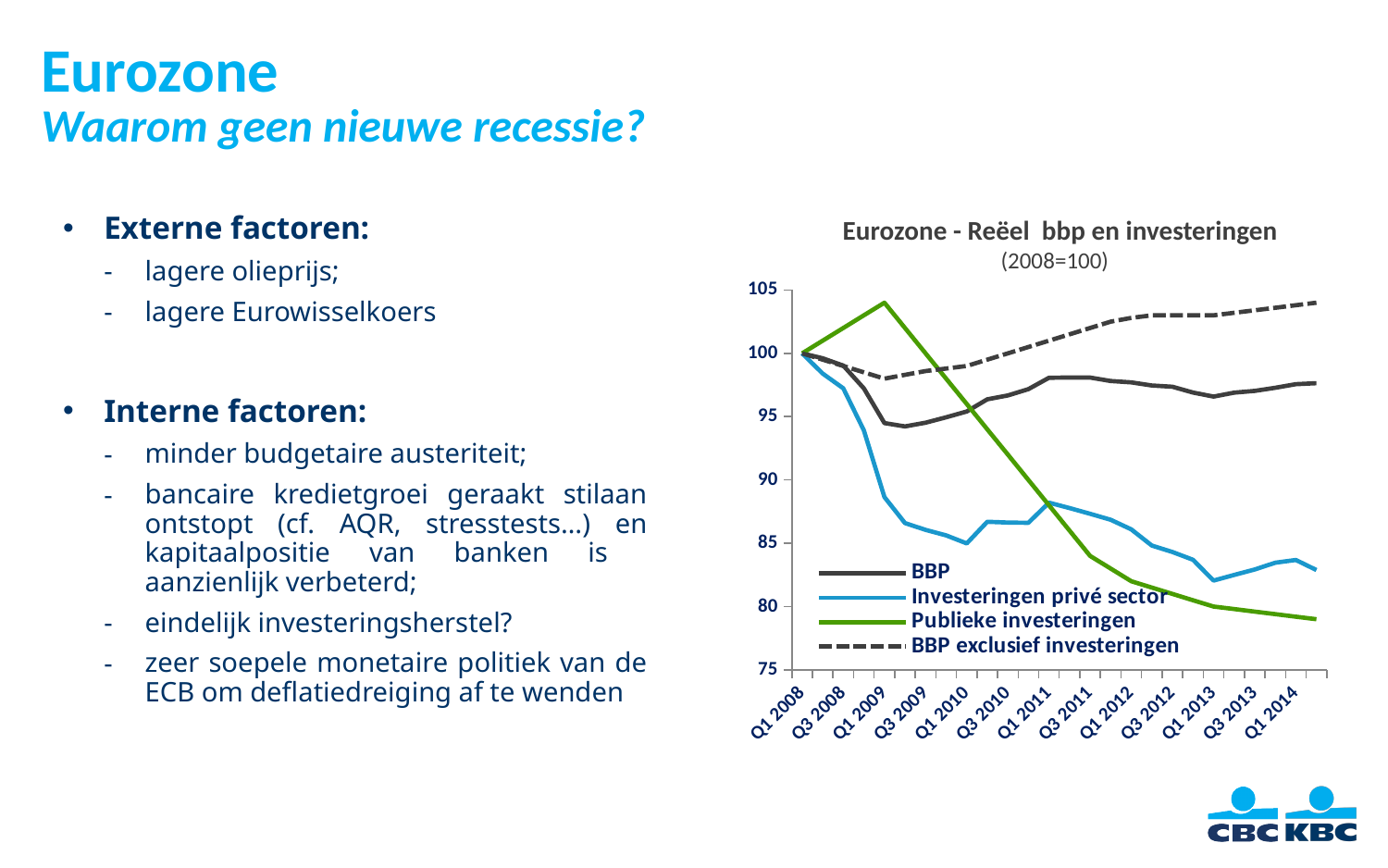
What is the value of BBP at Q1 2008? 100 Which is larger at Q1 2014: BBP or BBP exclusief investeringen? BBP exclusief investeringen Which series has the highest value at Q1 2014? BBP exclusief investeringen Is the value for BBP exclusief investeringen at Q1 2014 greater or less than 100? greater Does the Publieke investeringen series rise or fall from Q1 2009 to Q1 2014? fall Which series in the chart is drawn with a dashed line? BBP exclusief investeringen What is the title of the chart? Eurozone - Reëel bbp en investeringen Which series has the highest value at Q1 2009? Publieke investeringen Which series has the lowest value at Q1 2014? Publieke investeringen Is the value for Publieke investeringen at Q1 2014 greater or less than 80? less How many series does the chart legend list? 4 What type of chart is shown on the slide? line chart